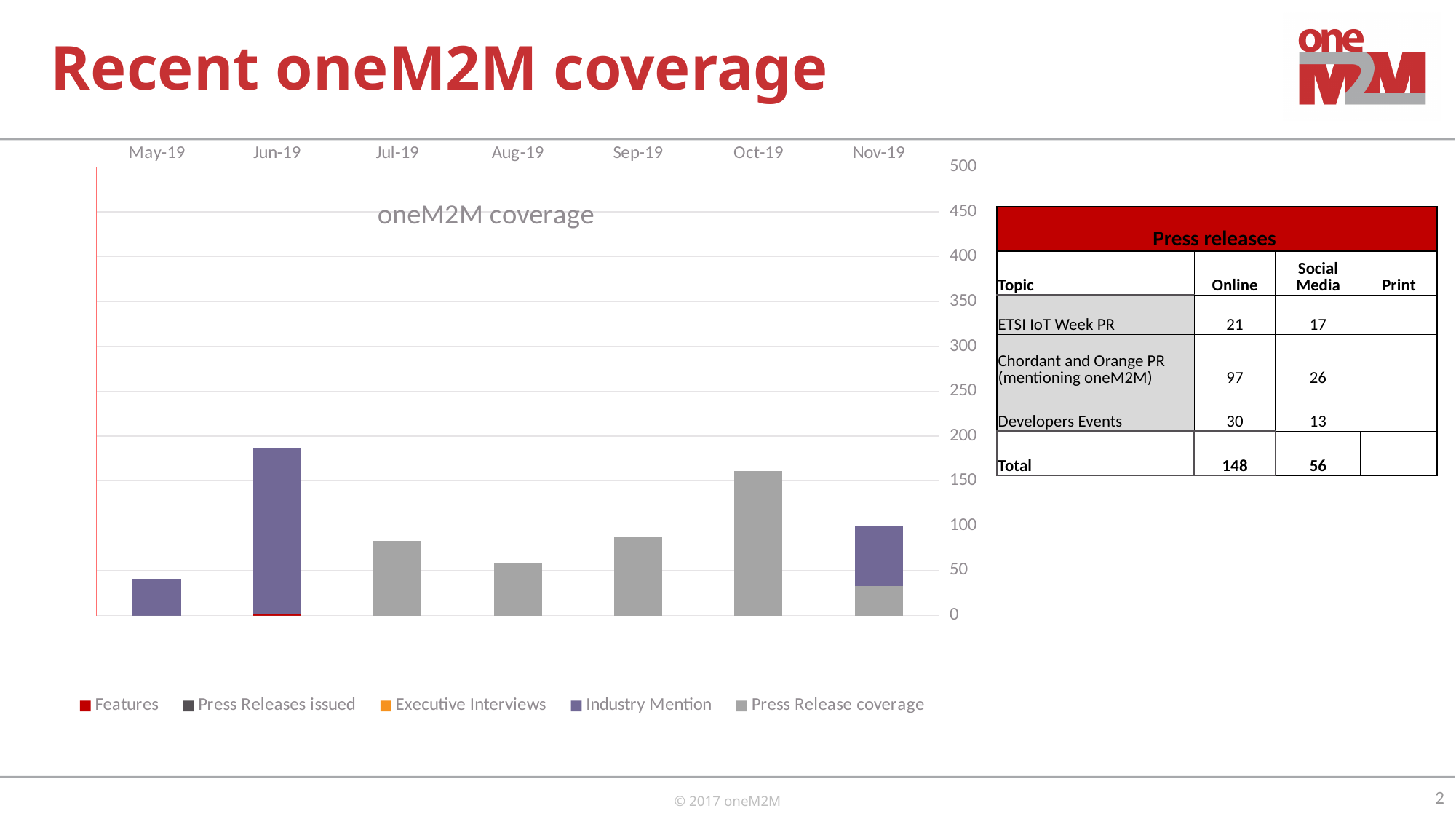
Is the bar for Aug-19 greater or less than 100? less How many months are shown on the x axis of the chart? 7 Is the bar for Oct-19 greater or less than 100? greater Which legend series is shown in gray in the chart? Press Release coverage Which month has the shortest bar in the chart? May-19 What is the title of the chart? oneM2M coverage Is the bar for May-19 greater or less than 50? less How many series does the chart legend list? 5 Which month has the taller bar, Sep-19 or Oct-19? Oct-19 Which month has the tallest bar in the chart? Jun-19 What kind of chart is shown on the slide? bar chart